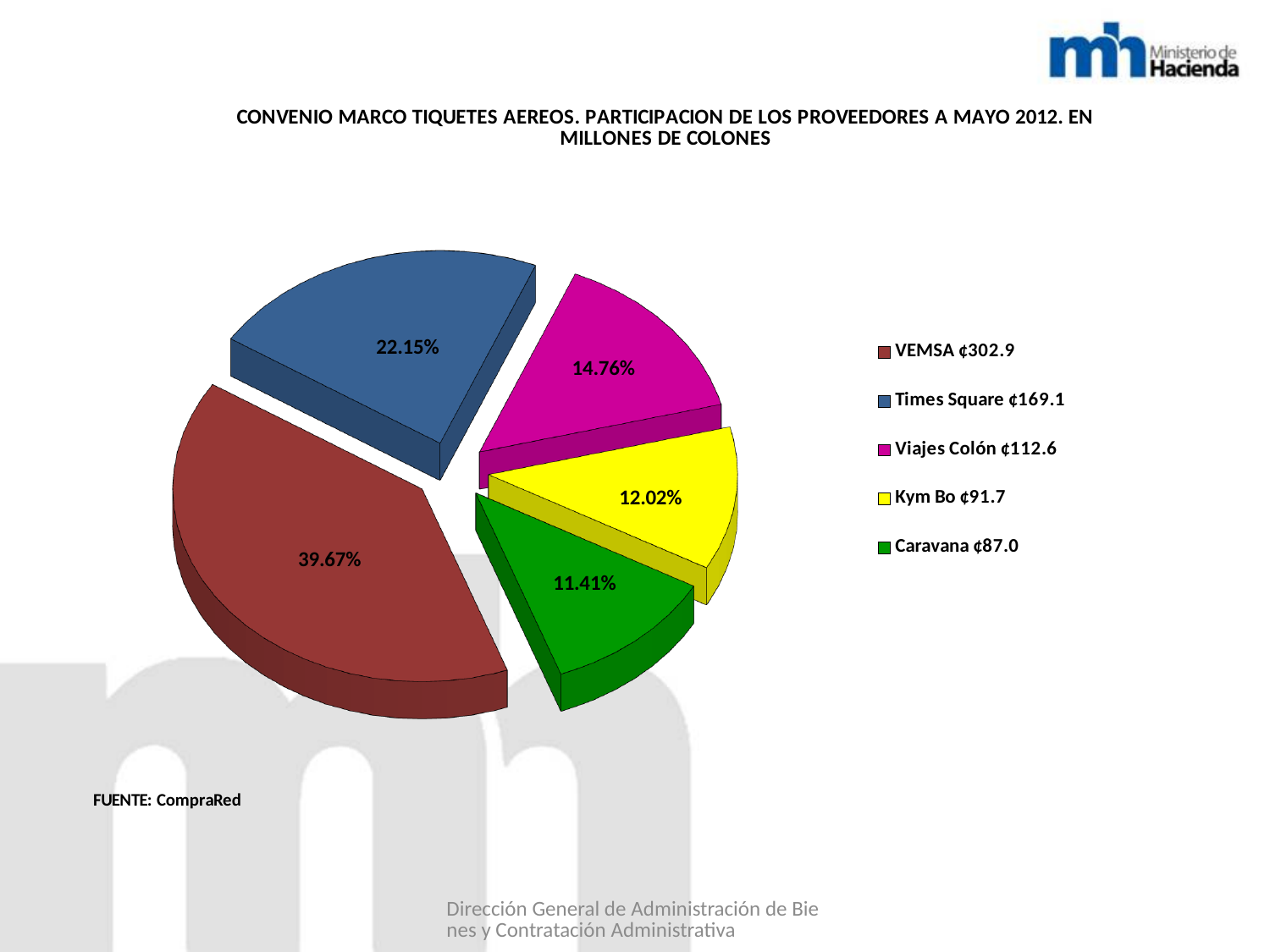
How many slices does the pie chart have? 5 Which has a larger share, Viajes Colón or Kym Bo? Viajes Colón What kind of chart is shown on the slide? pie chart What colour is the slice representing Kym Bo? yellow What value in millions of colones is shown for Viajes Colón in the legend? ¢112.6 What percentage share does the Times Square slice show? 22.15% What value in millions of colones is shown for Kym Bo in the legend? ¢91.7 What percentage share does the VEMSA slice show? 39.67% Which provider has the smallest share of the pie? Caravana What is the difference in percentage points between the VEMSA share and the Times Square share? 17.52 What percentage share does the Caravana slice show? 11.41% Which provider has the largest share of the pie? VEMSA